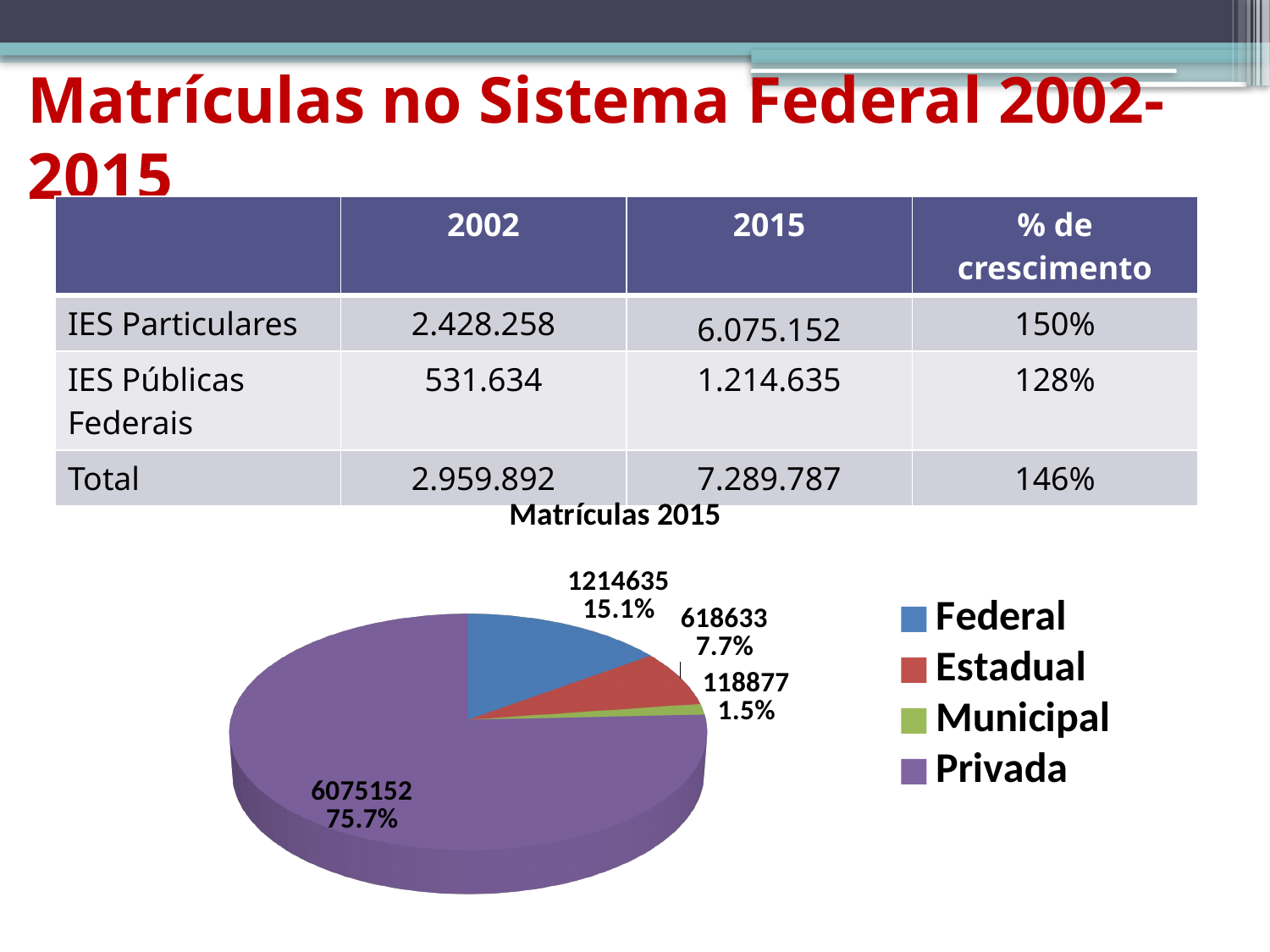
What share of the pie does Privada represent? 75.7% How many entries does the chart legend list? 4 Which category has the smallest slice in the pie chart? Municipal What is the title of the chart? Matrículas 2015 What share of the pie does Estadual represent? 7.7% How many slices does the pie chart have? 4 What is the difference between the Federal and Estadual values in the pie chart? 596002 What type of chart is shown on the slide? pie chart What is the value shown for Municipal in the pie chart? 118877 Which category has the largest slice in the pie chart? Privada What is the value shown for Federal in the pie chart? 1214635 What is the value shown for Privada in the pie chart? 6075152